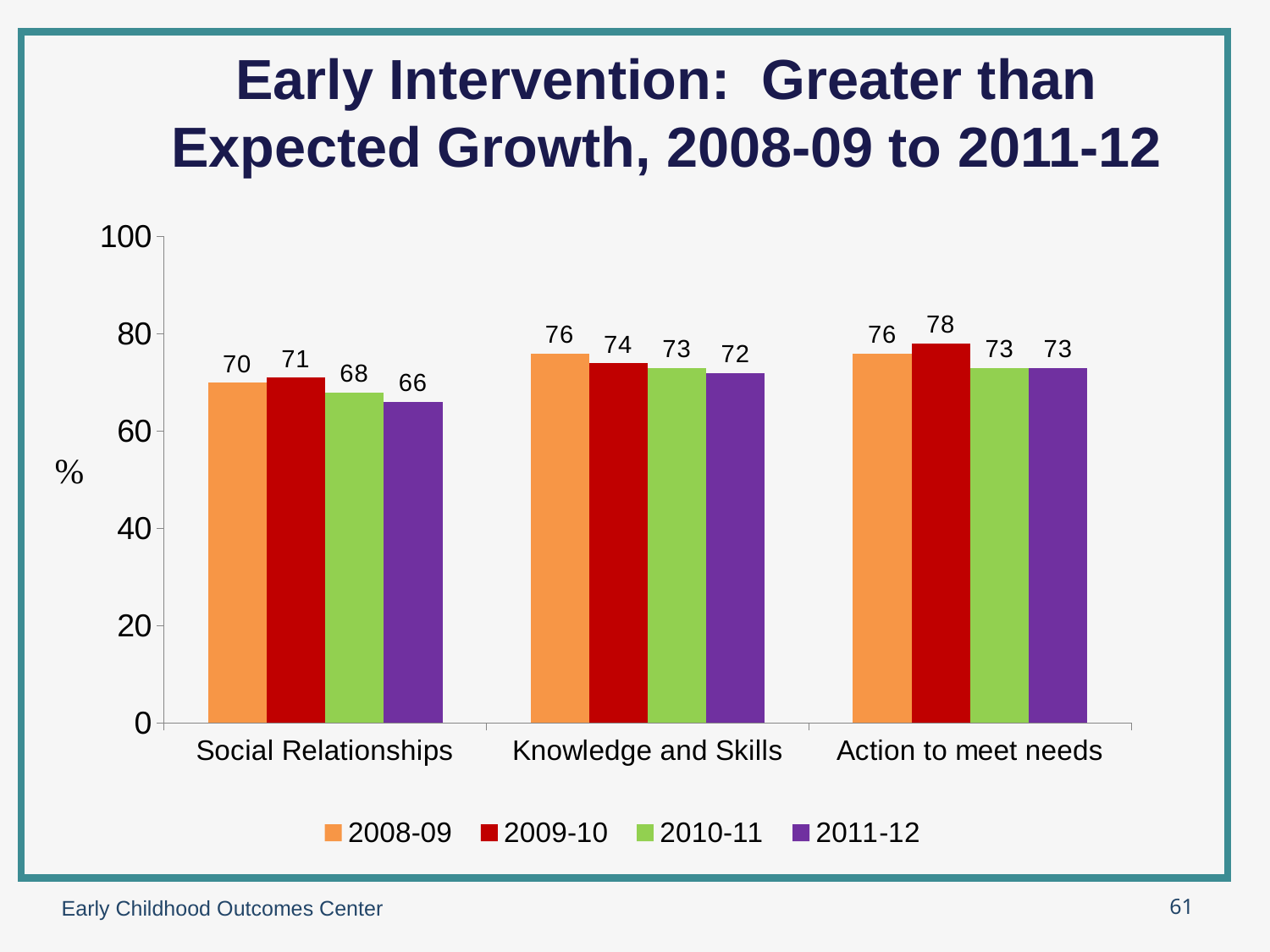
How many series does the legend list? 4 Which is larger: the 2009-10 value for Knowledge and Skills or the 2009-10 value for Action to meet needs? Action to meet needs What is the value for Knowledge and Skills in 2011-12? 72 Is the value for Social Relationships in 2011-12 greater or less than 80? less What is the difference between the 2008-09 and 2011-12 values for Social Relationships? 4 Which category has the lowest value in 2011-12? Social Relationships What is the value for Social Relationships in 2008-09? 70 What is the label on the vertical axis? % How many categories are shown on the x axis? 3 What kind of chart is shown on the slide? bar chart What is the value for Action to meet needs in 2009-10? 78 Which year has the highest value for Action to meet needs? 2009-10